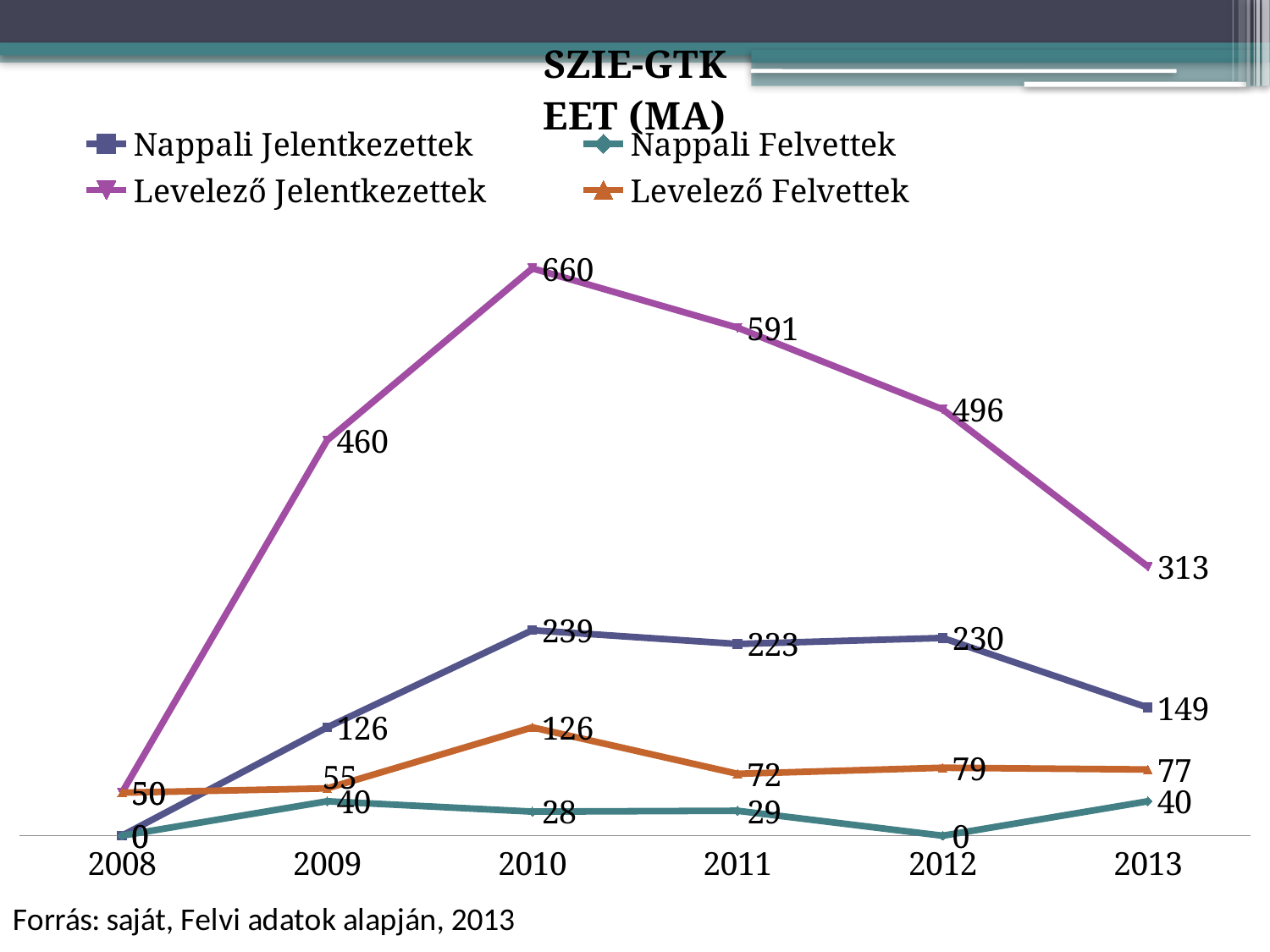
In which year does Levelező Jelentkezettek reach its highest value? 2010 What is the value for Levelező Felvettek in 2011? 72 Does the Levelező Jelentkezettek series rise or fall from 2010 to 2013? Fall In which year is Nappali Felvettek at its lowest between 2009 and 2013? 2012 What is the value for Nappali Jelentkezettek in 2013? 149 What kind of chart is shown on the slide? Line chart Which is larger for Nappali Jelentkezettek: the value in 2011 or in 2012? 2012 How many series does the legend list? 4 What is the value for Levelező Jelentkezettek in 2010? 660 How many years are shown on the x axis? 6 What is the value for Nappali Felvettek in 2012? 0 What is the difference between the Levelező Jelentkezettek values in 2010 and 2013? 347